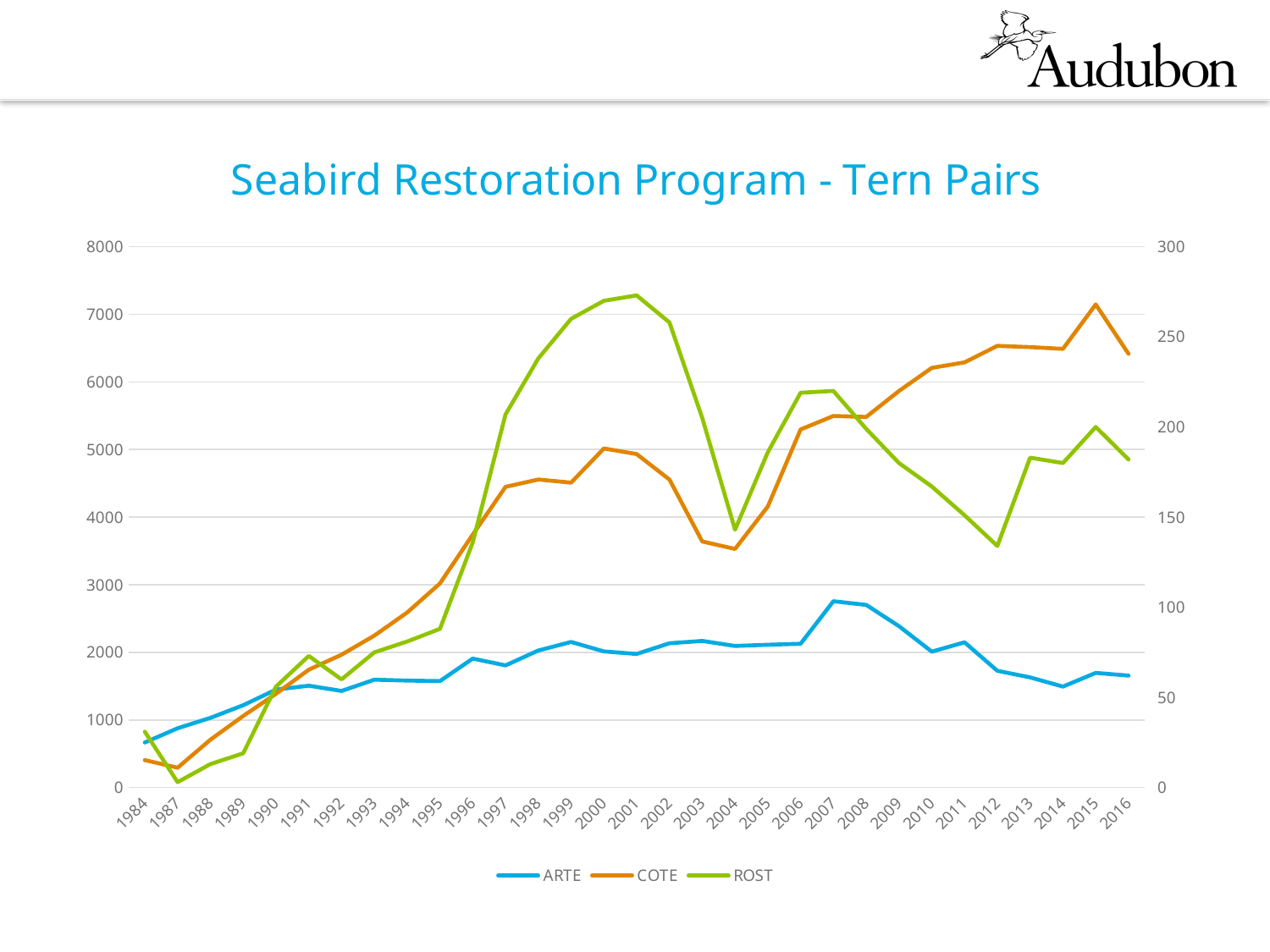
In which year is the ROST series at its lowest? 1987 Is the COTE value for 2015 greater or less than 7000 on the left axis? greater What is the title of the chart? Seabird Restoration Program - Tern Pairs Does the COTE series generally rise or fall from 1984 to 2016? rise Is the ARTE value for 2007 greater or less than 3000 on the left axis? less In which year does the COTE series reach its highest value? 2015 Which series is higher in 2016, COTE or ARTE? COTE What kind of chart is shown on the slide? line chart How many years are plotted along the x axis? 31 How many series does the legend list? 3 In which year does the ARTE series reach its highest value? 2007 Is the COTE value for 2004 greater or less than 4000 on the left axis? less